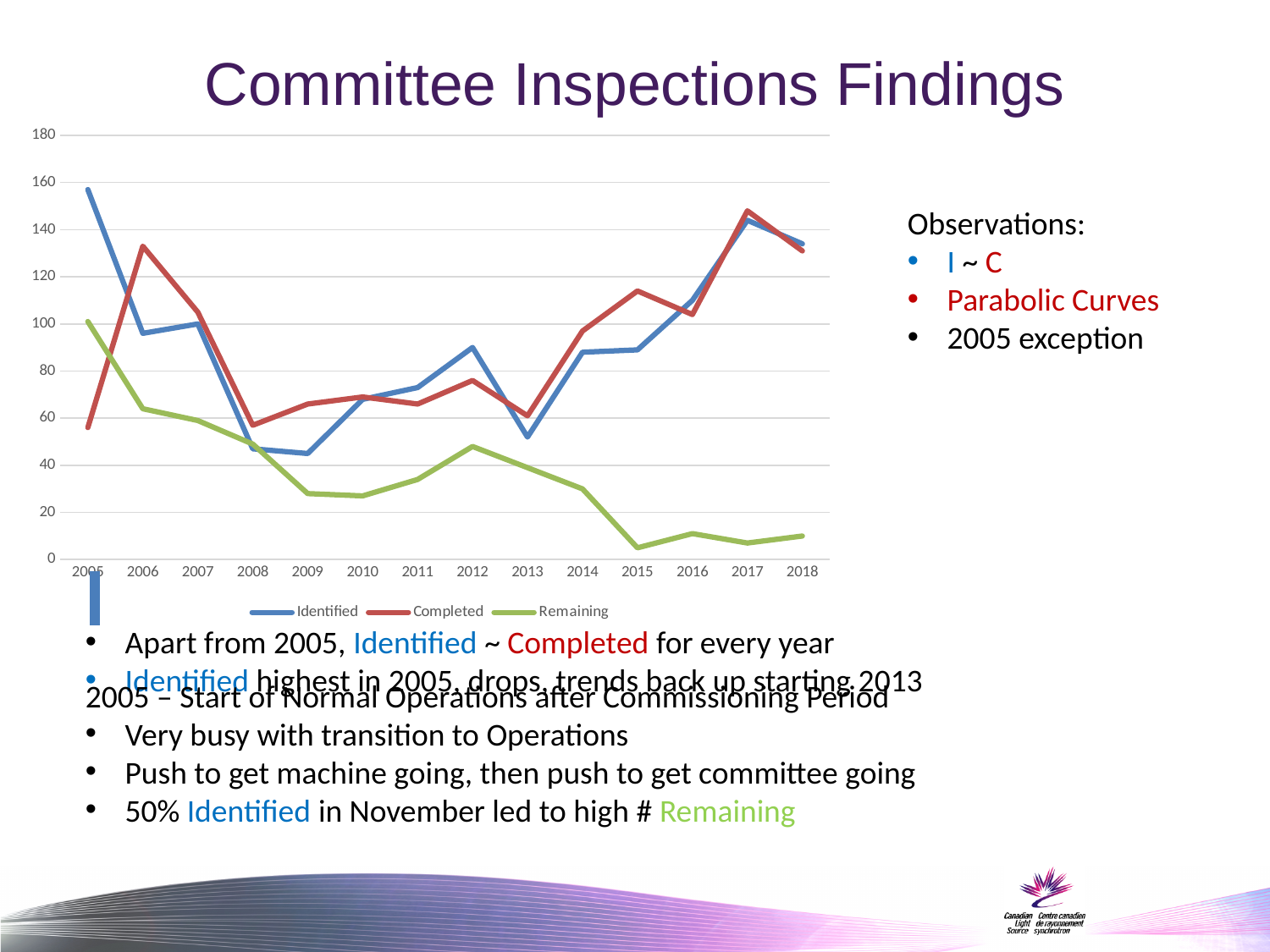
Does the Remaining series generally rise or fall from 2005 to 2015? Fall In 2012, which is larger: the Identified value or the Remaining value? Identified What kind of chart is shown on the slide? Line chart Is the Remaining value for 2015 greater or less than 20? less How many series does the chart legend list? 3 What colour is the Remaining series line in the chart? Green How many years are plotted along the x axis of the chart? 14 In 2006, which is larger: the Identified value or the Completed value? Completed Is the Completed value for 2005 greater or less than 80? less In which year is the Identified series at its highest? 2005 Is the Identified value for 2005 greater or less than 140? greater In which year is the Completed series at its highest? 2017